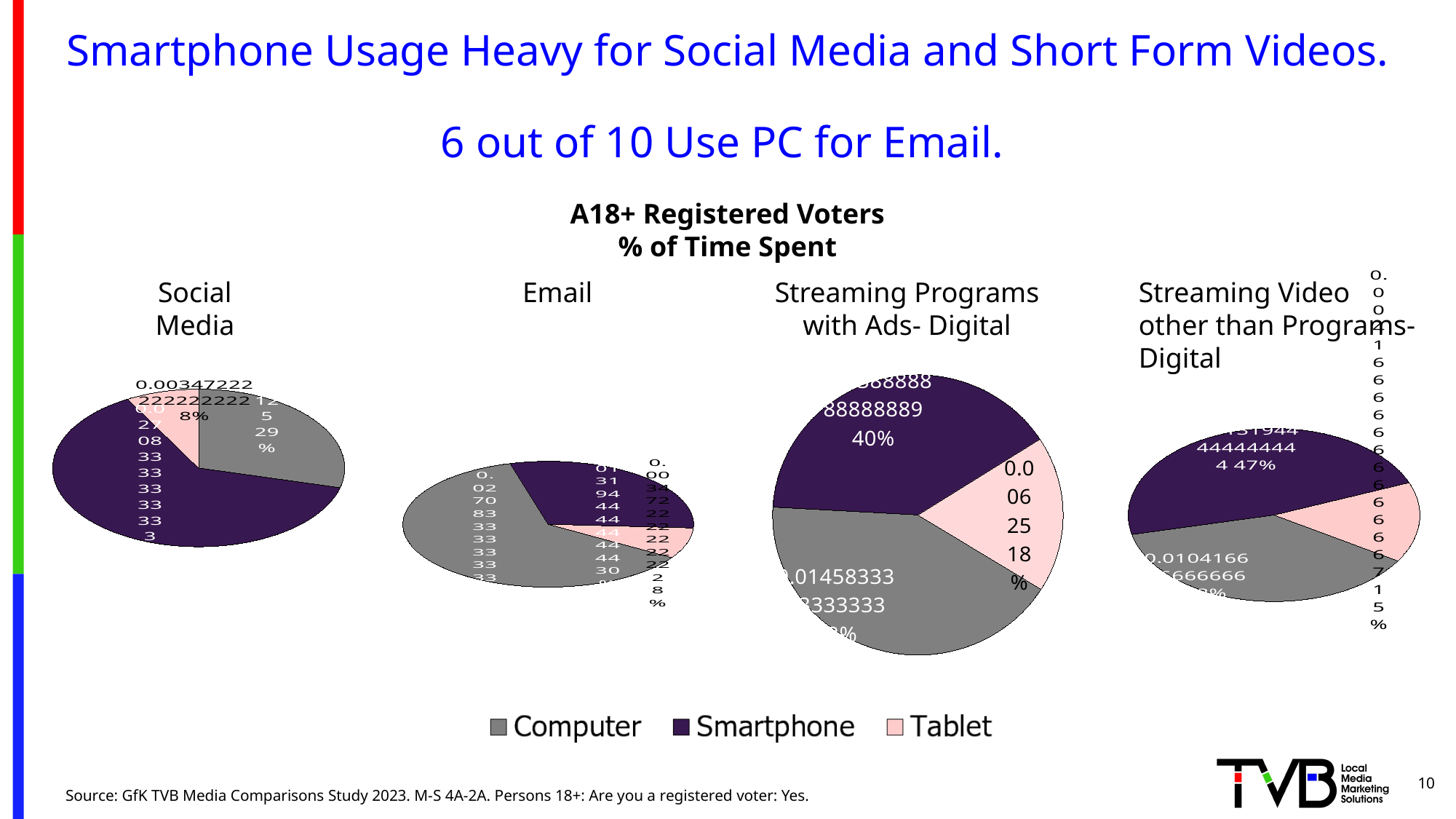
In the Streaming Video other than Programs- Digital pie chart, what percentage is shown for Smartphone? 47% In the Social Media pie chart, what percentage is shown for Tablet? 8% In the Email pie chart, which device has the largest share? Computer In the Social Media pie chart, which device has the largest share? Smartphone In the Social Media pie chart, what percentage is shown for Computer? 29% In the Streaming Programs with Ads- Digital pie chart, what percentage is shown for Smartphone? 40% In the Streaming Programs with Ads- Digital pie chart, what percentage is shown for Tablet? 18% How many pie charts are shown on the slide? 4 What kind of chart is used for the Social Media data on the slide? Pie chart In the Social Media pie chart, how many percentage points larger is the Computer share than the Tablet share? 21 In the Streaming Programs with Ads- Digital pie chart, which device has the smallest share? Tablet How many series does the legend list for the pie charts? 3